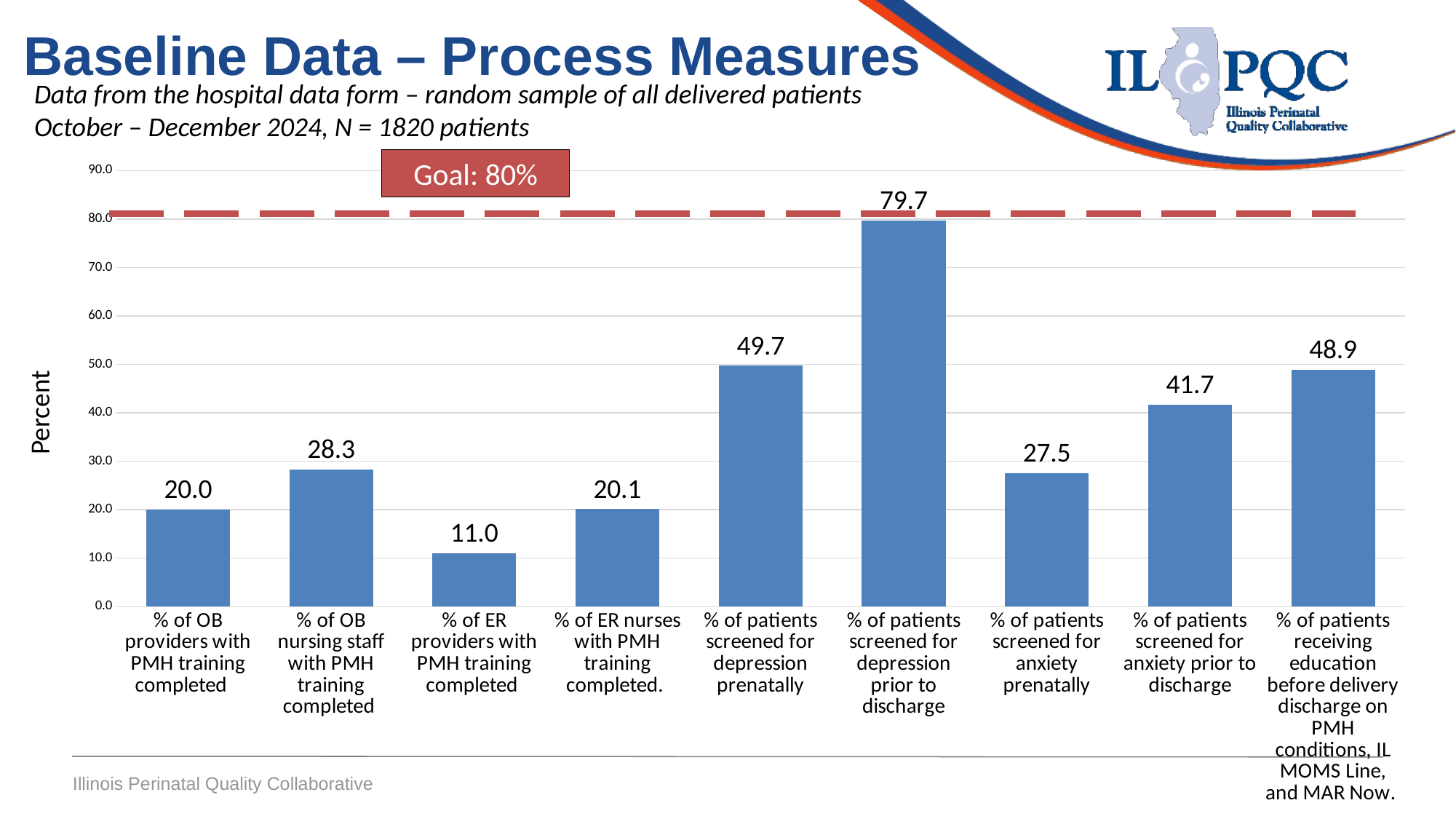
How many categories are shown on the chart? 9 What goal value is shown by the dashed line on the chart? 80% What is the label of the y axis? Percent Which category has the lowest value? % of ER providers with PMH training completed What is the value for % of patients screened for anxiety prior to discharge? 41.7 Is the value for % of patients receiving education before delivery discharge on PMH conditions, IL MOMS Line, and MAR Now greater or less than 40.0? greater What is the difference between % of patients screened for depression prenatally and % of patients screened for anxiety prenatally? 22.2 Which category has the highest value? % of patients screened for depression prior to discharge What is the value for % of patients screened for depression prior to discharge? 79.7 What kind of chart is shown on the slide? bar chart What is the value for % of OB nursing staff with PMH training completed? 28.3 Which is larger: % of OB providers with PMH training completed or % of OB nursing staff with PMH training completed? % of OB nursing staff with PMH training completed